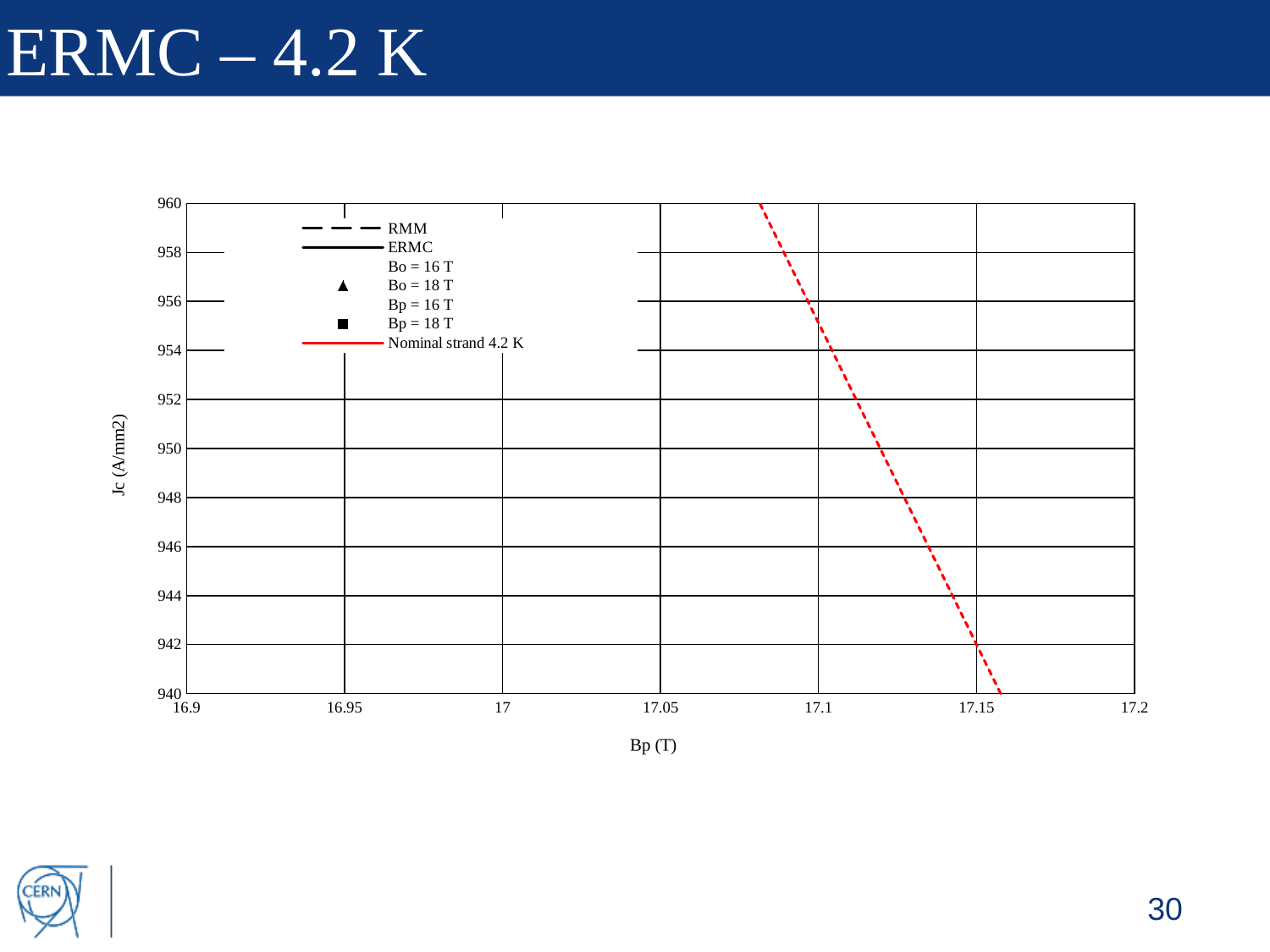
Is the Jc value of the Nominal strand 4.2 K line at Bp = 17.15 T greater or less than 946? less Does the Nominal strand 4.2 K line rise or fall as Bp increases? fall What is the minimum value shown on the x axis of the chart? 16.9 Which legend entry is drawn as a red dashed line in the chart? Nominal strand 4.2 K Is the Jc value of the Nominal strand 4.2 K line at Bp = 17.1 T greater or less than 958? less Is the Jc value of the Nominal strand 4.2 K line at Bp = 17.1 T greater or less than 950? greater What kind of chart is shown on the slide? line chart What is the label of the x axis of the chart? Bp (T) How many entries does the chart legend list? 7 What is the maximum value shown on the y axis of the chart? 960